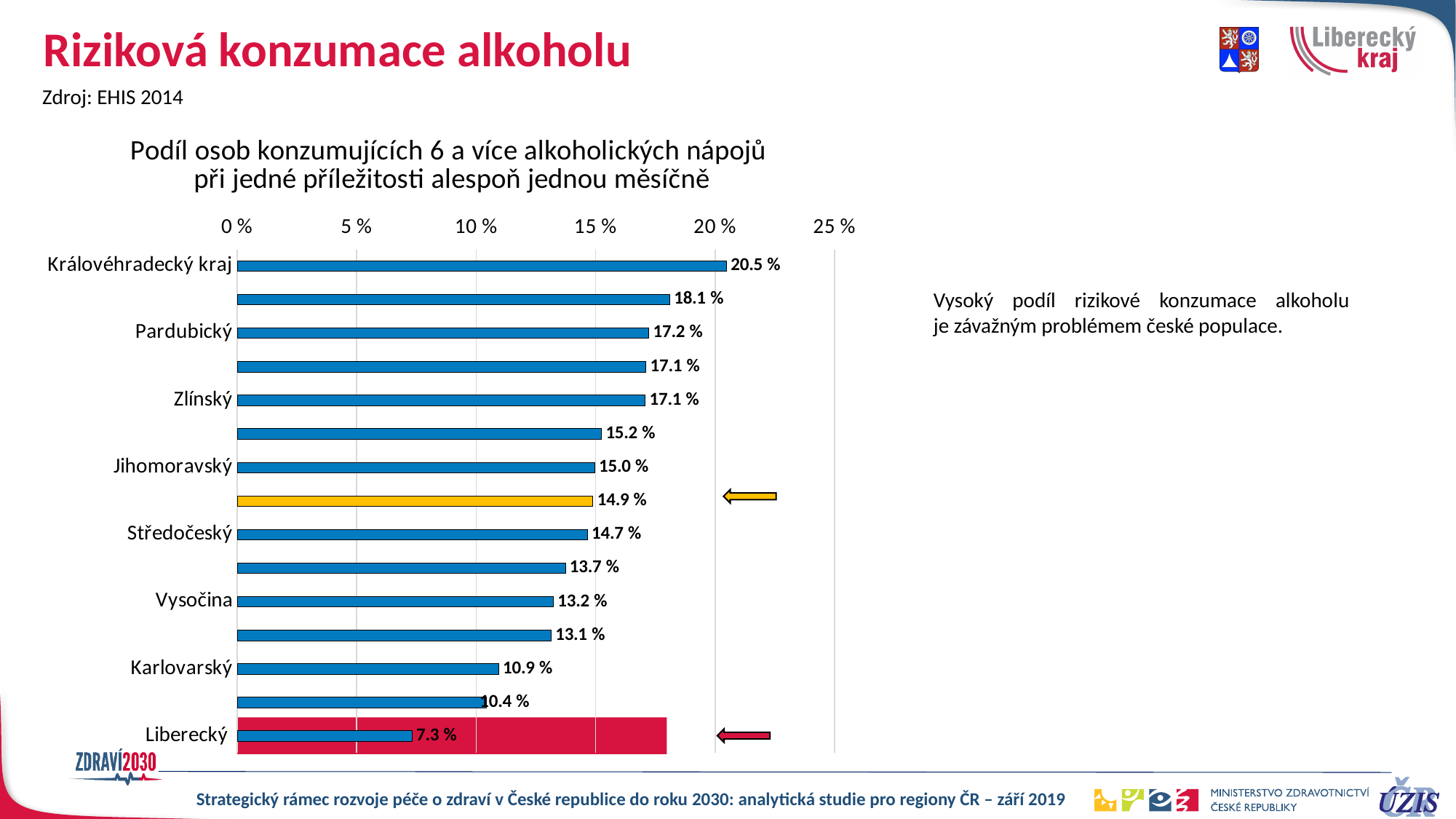
What kind of chart is shown on the slide? bar chart How many bars are plotted in the chart? 15 What is the difference between the values for Královéhradecký kraj and Liberecký? 13.2 % Which region has the lowest value? Liberecký What is the value for Liberecký? 7.3 % Which region has the highest value? Královéhradecký kraj What is the value for Karlovarský? 10.9 % Is the value for Vysočina greater or less than 15 %? less What is the value for Královéhradecký kraj? 20.5 % Which is larger, the value for Pardubický or the value for Jihomoravský? Pardubický What is the value for Jihomoravský? 15.0 % What is the value of the bar highlighted in yellow? 14.9 %